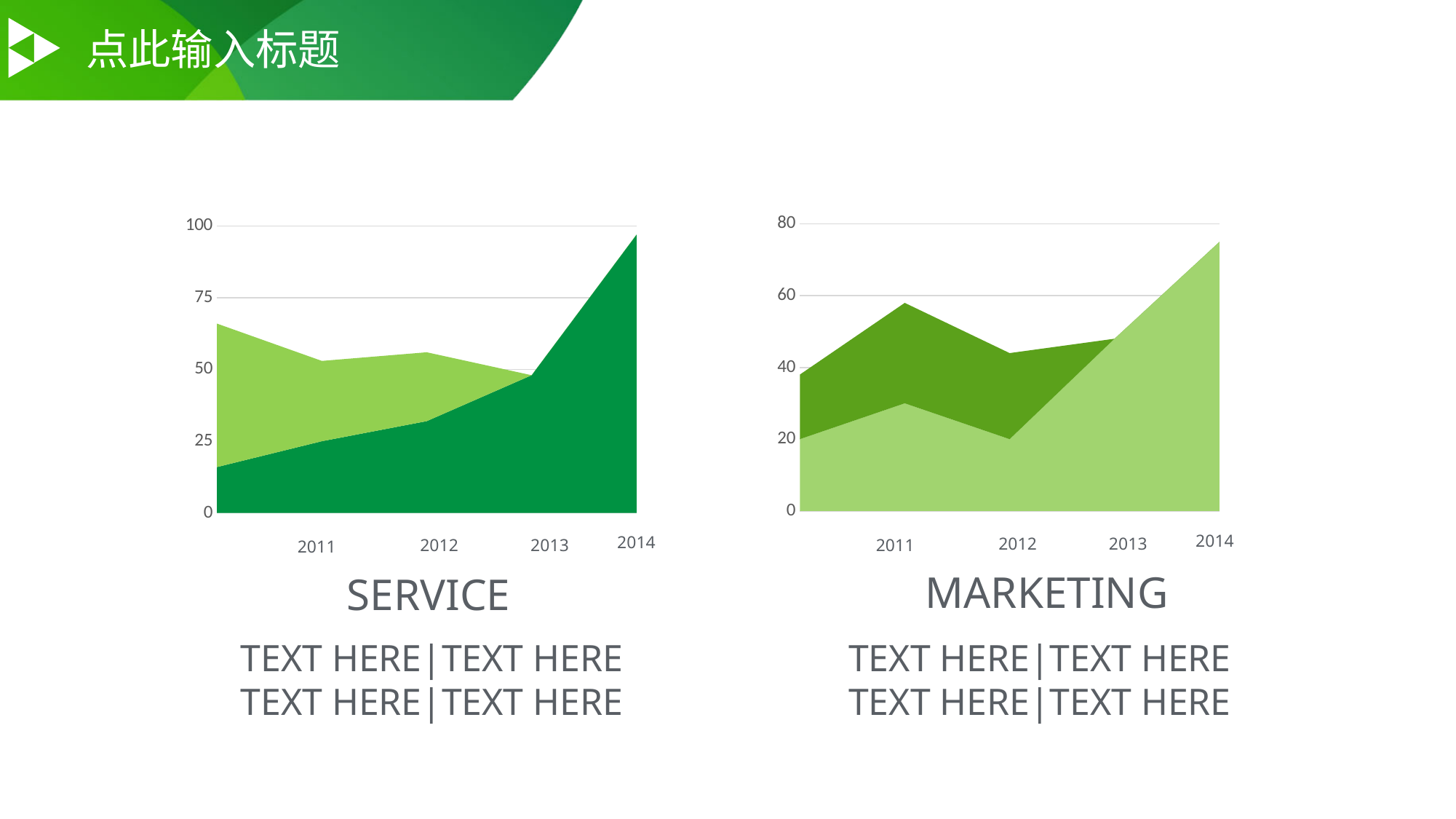
In the SERVICE chart, in which year does the dark green series reach its highest value? 2014 In the MARKETING chart, is the value of the light green series for 2011 greater or less than 20? greater What kind of chart is the SERVICE chart on the left? area chart What is the highest value shown on the y axis of the MARKETING chart? 80 What kind of chart is the MARKETING chart on the right? area chart In the MARKETING chart, is the value of the light green series for 2014 greater or less than 60? greater In the SERVICE chart, does the dark green series rise or fall from 2011 to 2014? rise In the SERVICE chart, is the value of the dark green series for 2012 greater or less than 25? greater In the MARKETING chart, in which year does the light green series reach its highest value? 2014 In the MARKETING chart, in which year does the dark green series reach its highest value? 2011 What is the highest value shown on the y axis of the SERVICE chart? 100